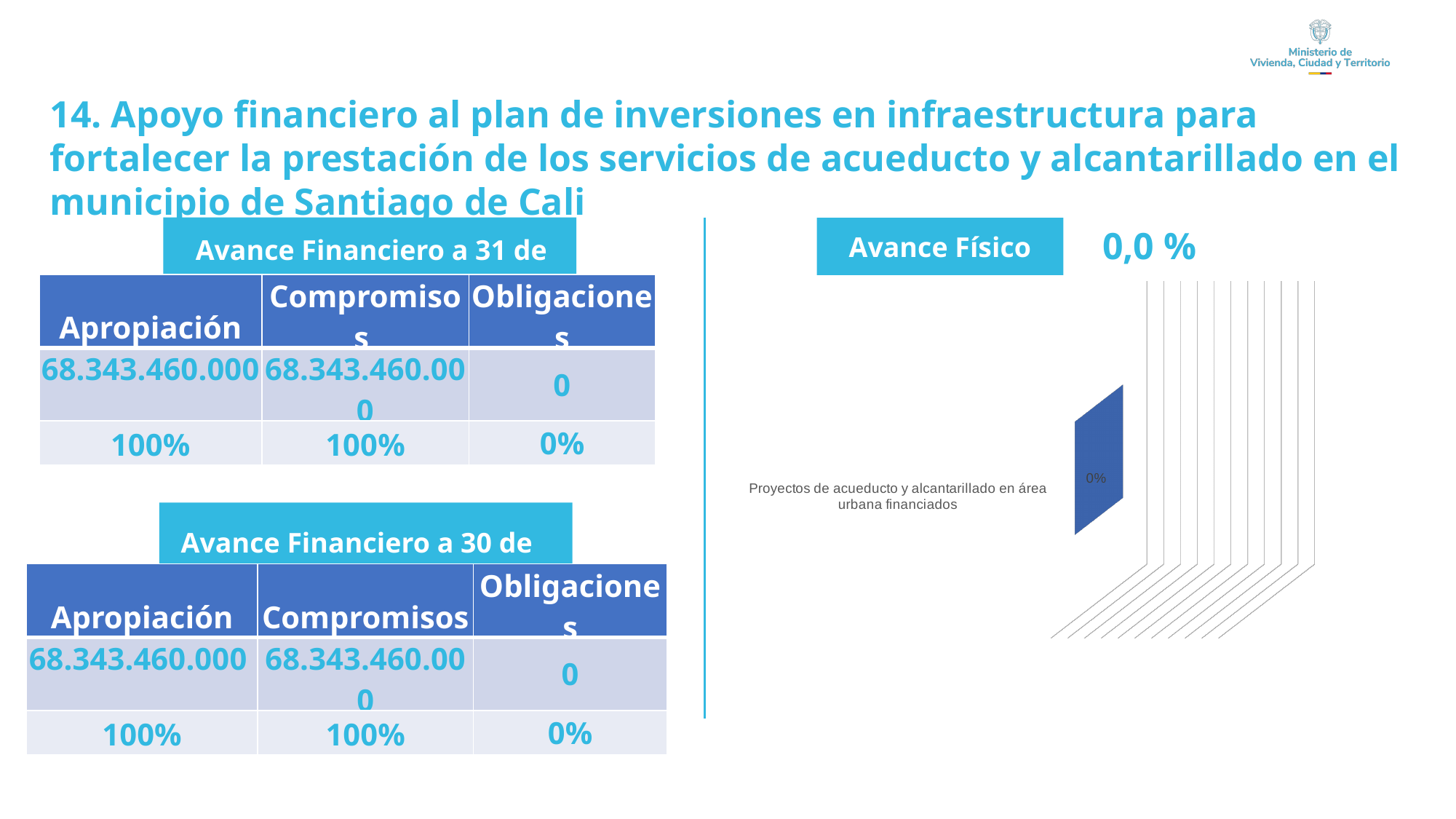
What percentage is displayed next to the Avance Físico heading above the chart? 0,0 % What is the category label of the single bar in the Avance Físico chart? Proyectos de acueducto y alcantarillado en área urbana financiados What kind of chart is shown under the Avance Físico heading? bar chart In the Avance Físico chart, what is the value shown for "Proyectos de acueducto y alcantarillado en área urbana financiados"? 0% How many categories are plotted in the Avance Físico chart? 1